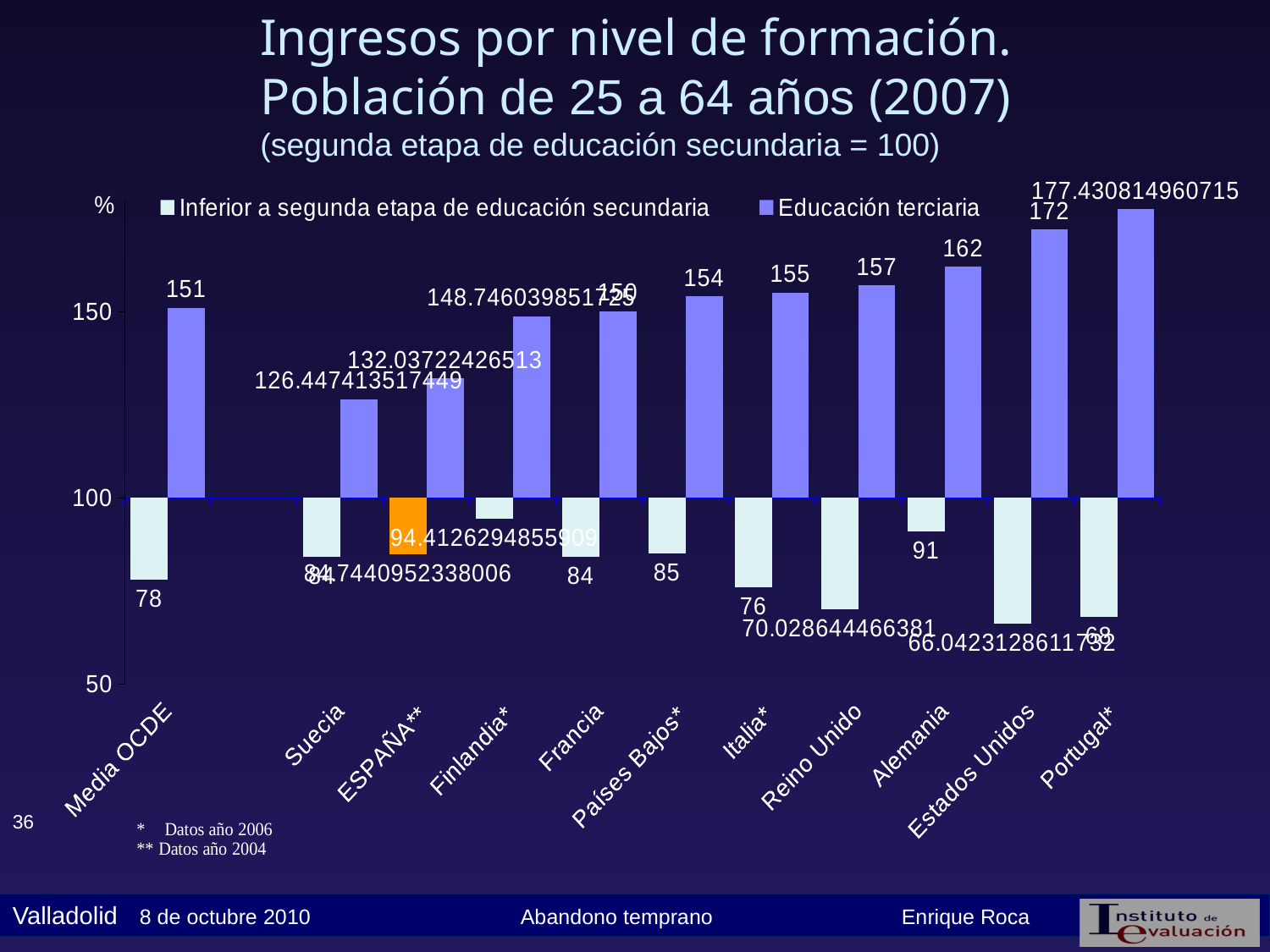
How many series does the legend list? 2 Which category has the highest value for Educación terciaria? Portugal* What is the value of Educación terciaria for Alemania? 162 What kind of chart is shown on the slide? bar chart Which category has the lowest value for Educación terciaria? Suecia What is the value of Educación terciaria for Media OCDE? 151 How many categories (countries/regions) are labelled on the x axis? 11 Which category has the lowest value for Inferior a segunda etapa de educación secundaria? Estados Unidos What is the value of Inferior a segunda etapa de educación secundaria for Italia*? 76 Is the Educación terciaria value for Suecia greater or less than 150? less For Media OCDE, what is the difference between the Educación terciaria value and the Inferior a segunda etapa de educación secundaria value? 73 Which has a higher Educación terciaria value, Estados Unidos or Alemania? Estados Unidos